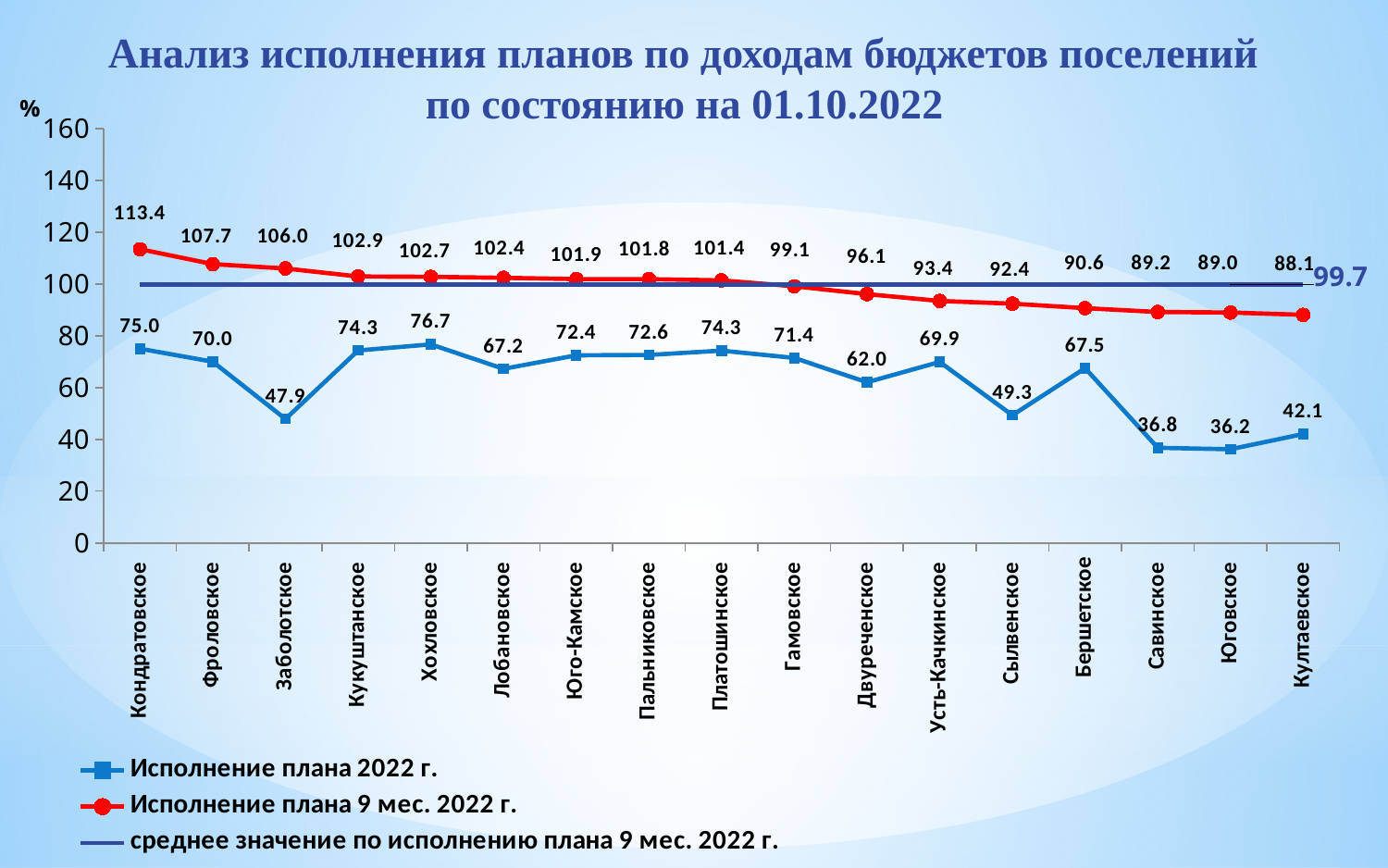
What is the title of the chart? Анализ исполнения планов по доходам бюджетов поселений по состоянию на 01.10.2022 Which settlement has the lowest value for 'Исполнение плана 2022 г.'? Юговское What is the difference between 'Исполнение плана 9 мес. 2022 г.' and 'Исполнение плана 2022 г.' for Култаевское? 46.0 Does the 'Исполнение плана 9 мес. 2022 г.' series generally rise or fall from left to right along the x axis? fall Which is larger for Хохловское: 'Исполнение плана 2022 г.' or 'Исполнение плана 9 мес. 2022 г.'? Исполнение плана 9 мес. 2022 г. How many settlements (categories) are plotted along the x axis? 17 What type of chart is shown on the slide? line chart What is the value of 'Исполнение плана 2022 г.' for Заболотское? 47.9 Which settlement has the highest value for 'Исполнение плана 9 мес. 2022 г.'? Кондратовское What is the value of 'Исполнение плана 9 мес. 2022 г.' for Кондратовское? 113.4 How many series does the legend list? 3 What is the value of the line 'среднее значение по исполнению плана 9 мес. 2022 г.'? 99.7